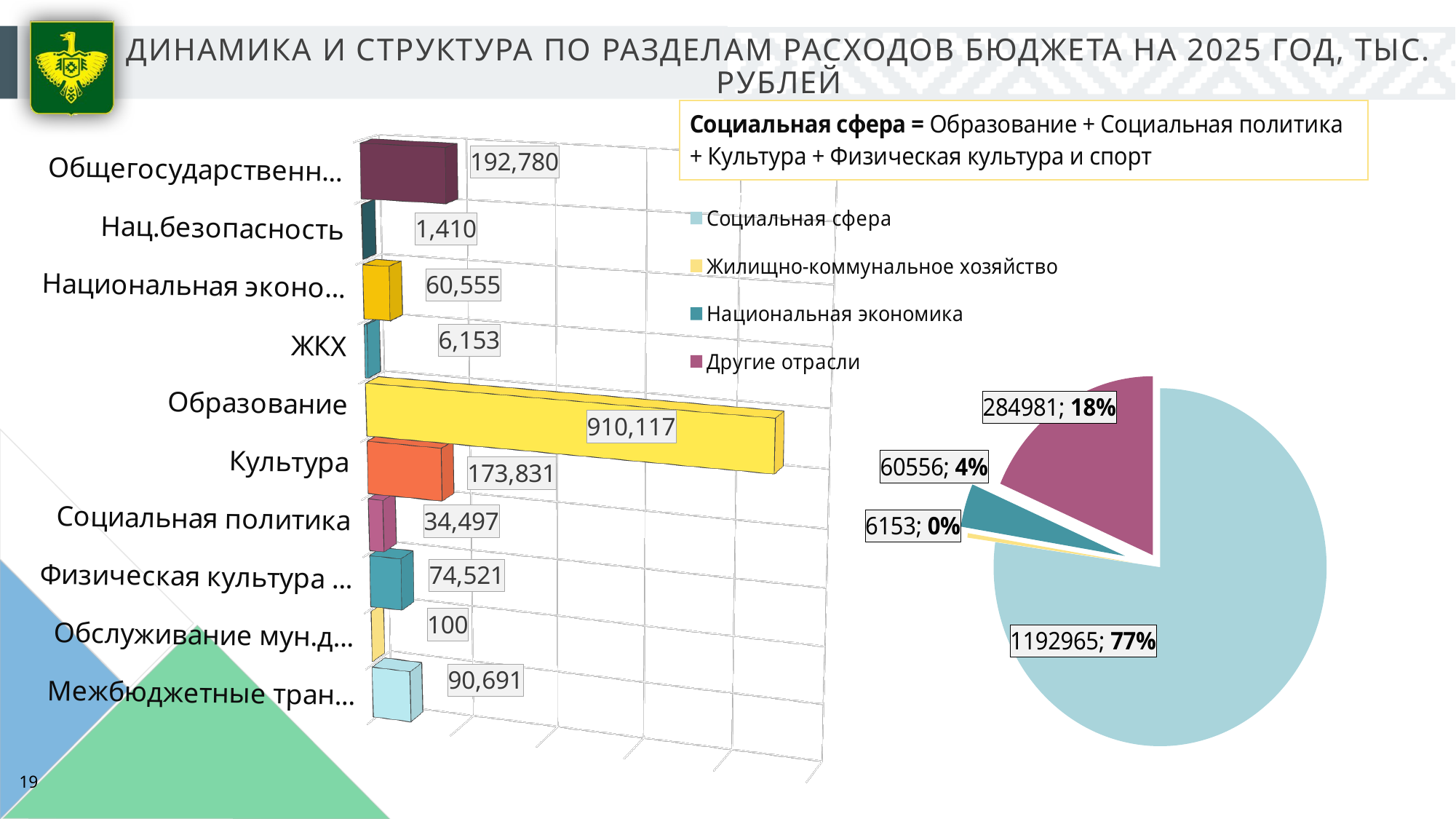
In the bar chart on the left, what is the value for Социальная политика? 34,497 How many categories does the bar chart on the left show? 10 In the bar chart on the left, which category has the highest value? Образование How many entries does the legend of the pie chart on the right list? 4 In the pie chart on the right, what share does Социальная сфера have? 77% In the bar chart on the left, what is the value for ЖКХ? 6,153 In the bar chart on the left, which is larger: Нац.безопасность or ЖКХ? ЖКХ In the bar chart on the left, which category has the lowest value? Обслуживание мун.д... In the pie chart on the right, what is the value for Другие отрасли? 284981 In the bar chart on the left, what is the value for Образование? 910,117 In the bar chart on the left, what is the value for Культура? 173,831 In the bar chart on the left, what is the difference between Культура and Социальная политика? 139,334